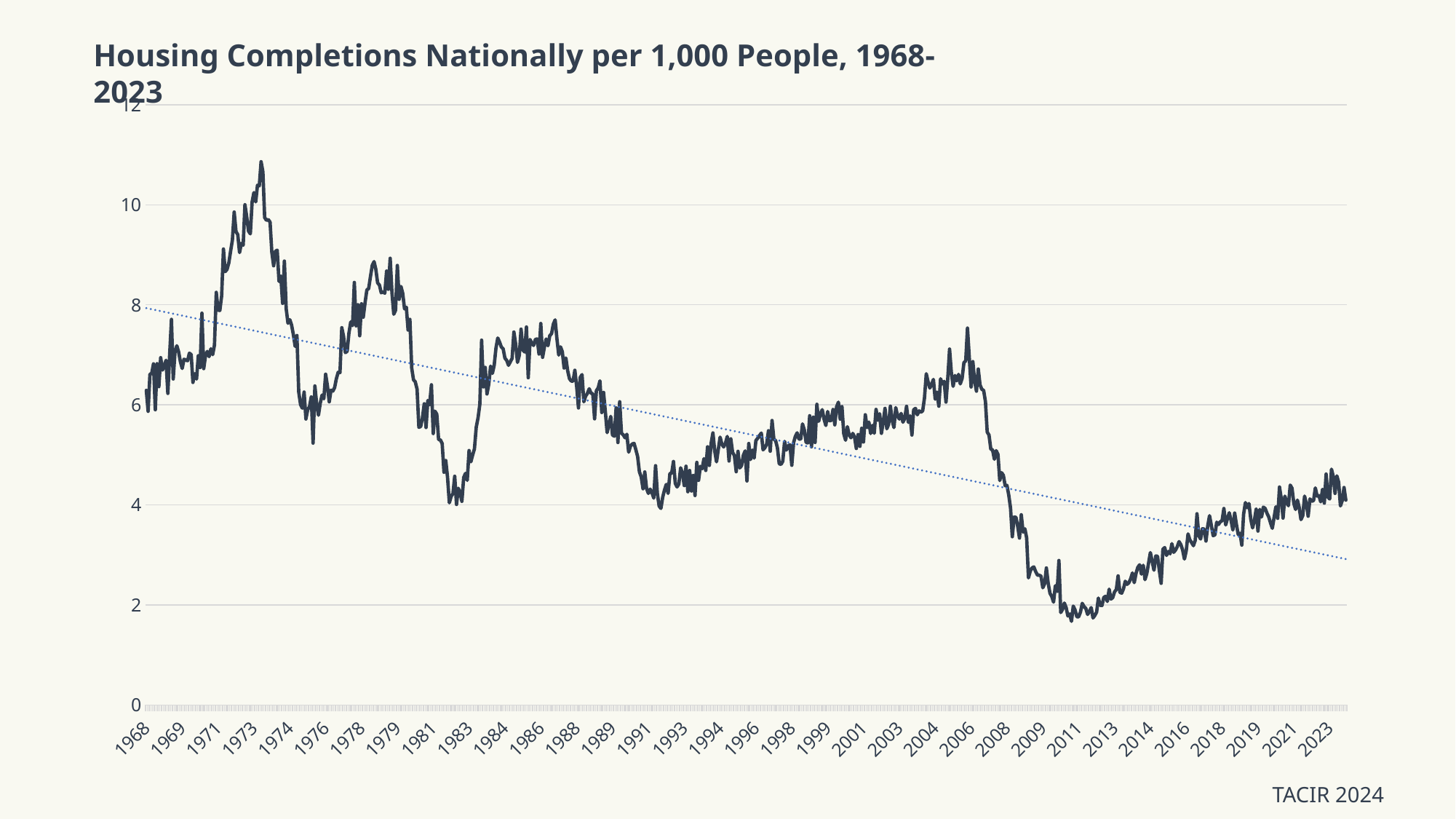
Is the lowest value around 2011 greater or less than 2? less Is the peak value around 1973 greater or less than 10? greater Does the dotted trend line rise or fall from 1968 to 2023? fall What kind of chart is shown on the slide? line chart Is the value around 1991 greater or less than 6? less What is the title of the chart? Housing Completions Nationally per 1,000 People, 1968-2023 Which is larger, the value around 1973 or the value around 2011? 1973 What is the highest value shown on the y axis? 12 Around which year labelled on the x axis does the line reach its highest point? 1973 Around which year labelled on the x axis does the line reach its lowest point? 2011